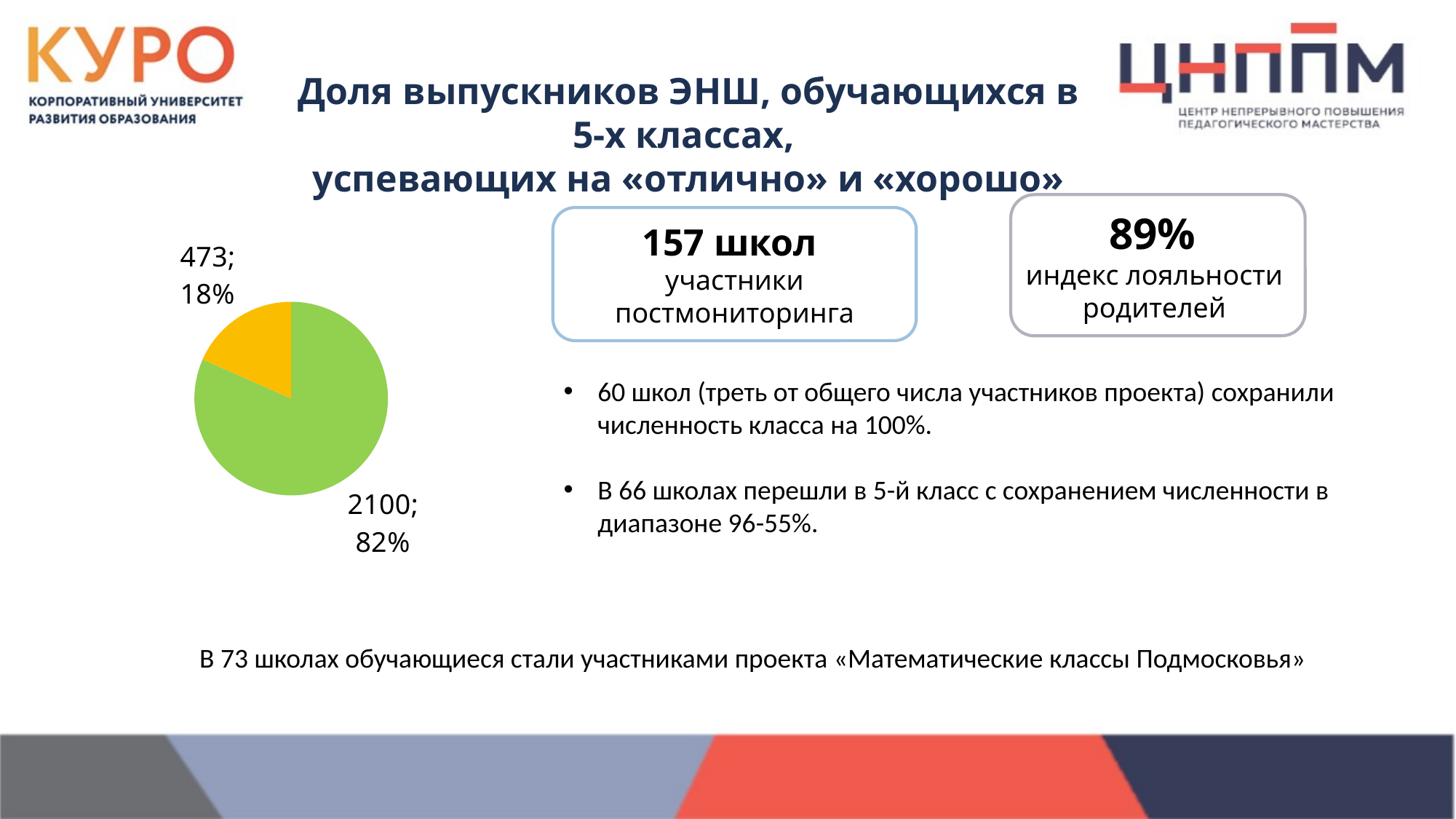
What colours are used for the two slices of the pie chart? green and yellow What kind of chart is shown on the slide? pie chart Which is larger in the pie chart: the green slice or the yellow slice? the green slice Which slice of the pie chart is the smallest? the yellow slice (473; 18%) What is the total of the two values shown on the pie chart? 2573 What value is labelled on the yellow slice of the pie chart? 473 How many slices does the pie chart have? 2 What percentage share does the green slice of the pie chart represent? 82% What value is labelled on the green slice of the pie chart? 2100 What percentage share does the yellow slice of the pie chart represent? 18% What is the difference between the values of the green and yellow slices of the pie chart? 1627 Which slice of the pie chart is the largest? the green slice (2100; 82%)